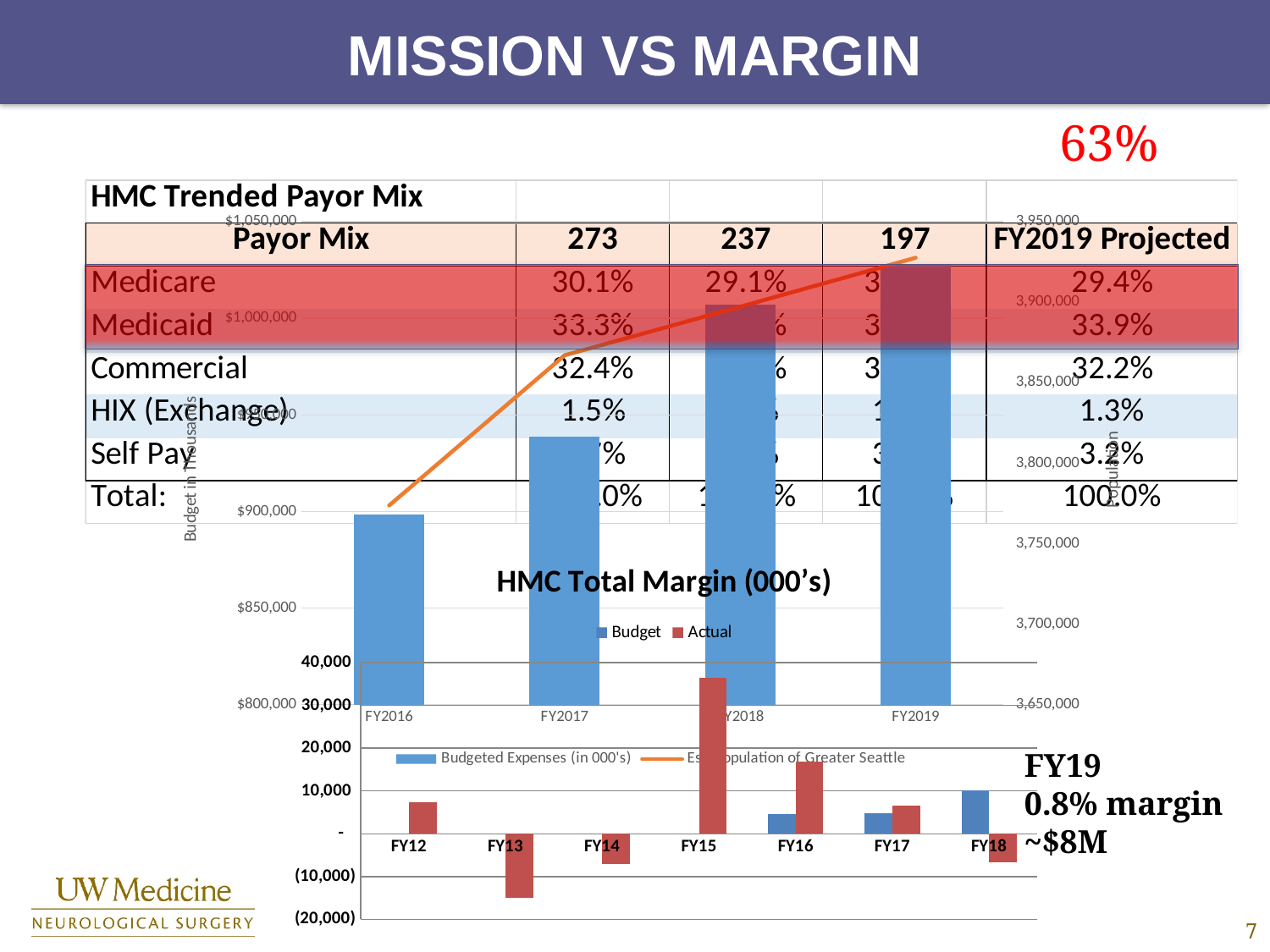
On the HMC Total Margin (000's) chart, which is larger for FY16: the Budget value or the Actual value? Actual On the Budgeted Expenses chart with the FY2016–FY2019 x axis, is the budgeted expenses value for FY2017 greater or less than $900,000? greater On the HMC Total Margin (000's) chart, is the Actual value for FY15 greater or less than 30,000? greater On the HMC Total Margin (000's) chart, how many series does the legend list? 2 On the HMC Total Margin (000's) chart, which fiscal year has the highest Actual value? FY15 On the HMC Total Margin (000's) chart, how many fiscal years are shown on the x axis? 7 On the Budgeted Expenses chart with the FY2016–FY2019 x axis, do the budgeted expense bars rise or fall from FY2016 to FY2019? rise On the HMC Total Margin (000's) chart, is the Actual value for FY16 greater or less than 10,000? greater On the HMC Total Margin (000's) chart, what are the two series named in the legend? Budget and Actual What kind of chart is the HMC Total Margin (000's) chart? Bar chart On the HMC Total Margin (000's) chart, which fiscal year has the lowest Actual value? FY13 On the Budgeted Expenses chart with the FY2016–FY2019 x axis, how many fiscal years are plotted? 4